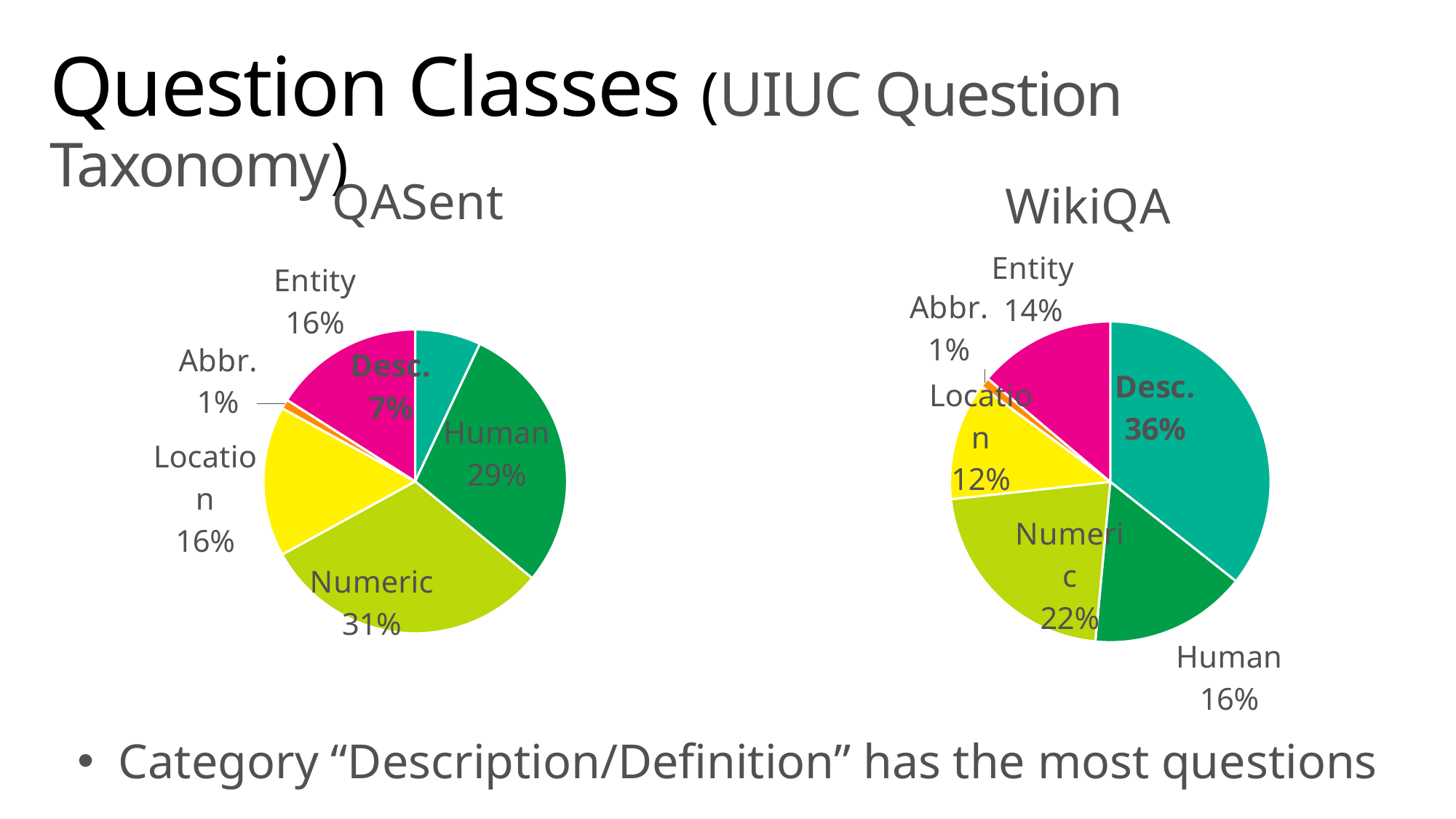
In the WikiQA pie chart, what percentage is Location? 12% In the QASent pie chart, how many percentage points larger is Numeric than Human? 2 percentage points Is the Human share larger in the QASent chart or the WikiQA chart? QASent In the WikiQA pie chart, which category has the smallest share? Abbr. In the WikiQA pie chart, which category has the largest share? Desc. In the WikiQA pie chart, what is the difference between the Desc. share and the Human share? 20 percentage points What type of chart is used for the WikiQA data? Pie chart In the QASent pie chart, what percentage is labelled Human? 29% In the WikiQA pie chart, what share is labelled Desc.? 36% In the QASent pie chart, which category has the largest share? Numeric In the QASent pie chart, what share of questions is Numeric? 31% How many categories does the QASent pie chart show? 6